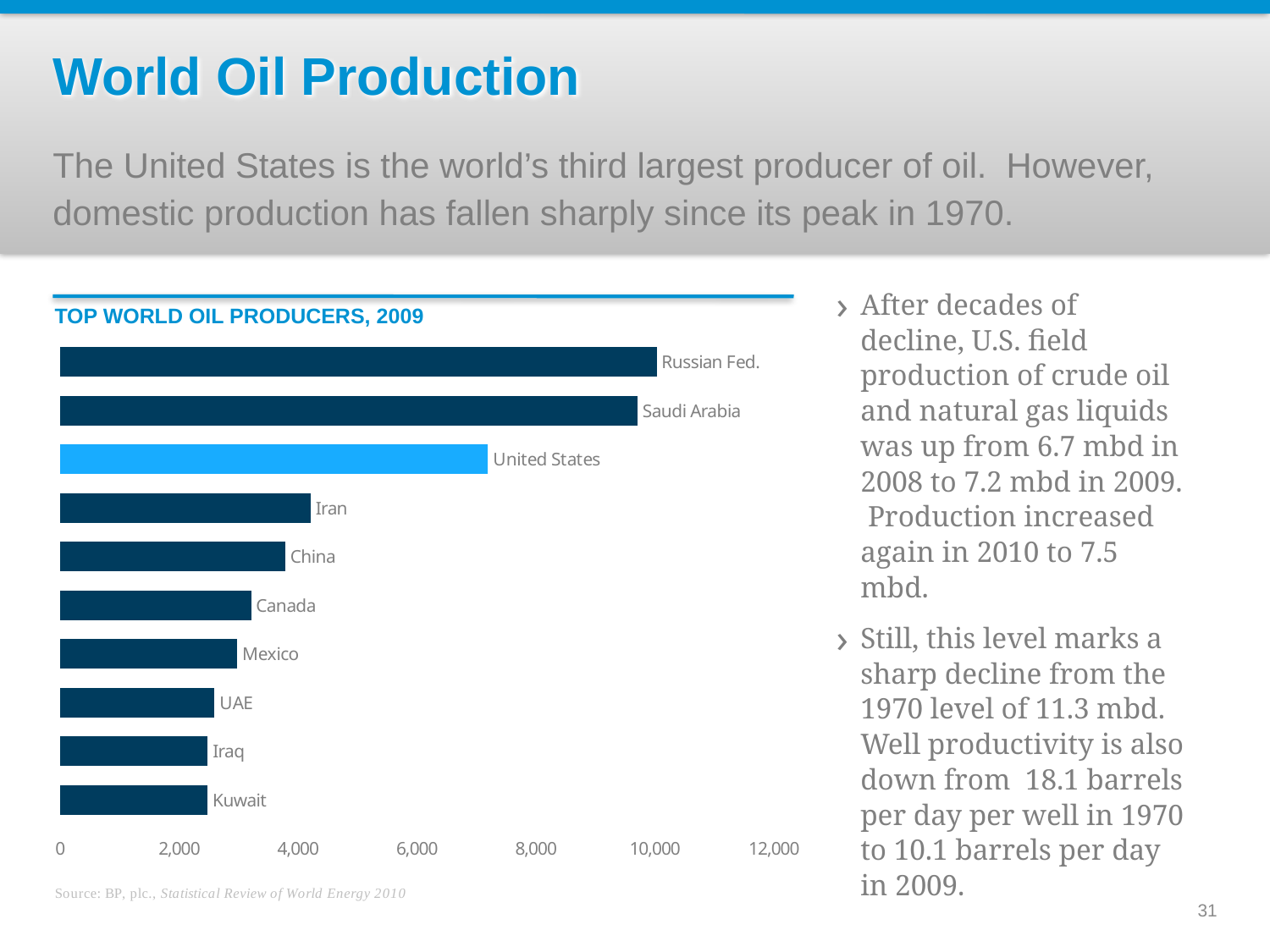
What is the title of the chart? TOP WORLD OIL PRODUCERS, 2009 Which has a larger value, Canada or UAE? Canada Is the value for United States greater or less than 6,000? greater Is the value for United States greater or less than 8,000? less Which country has the highest oil production in the chart? Russian Fed. What type of chart is shown on the slide? bar chart Which country's bar is shown in a lighter blue colour than the others? United States Which has a larger value, United States or Iran? United States Is the value for Canada greater or less than 4,000? less How many countries are shown in the chart? 10